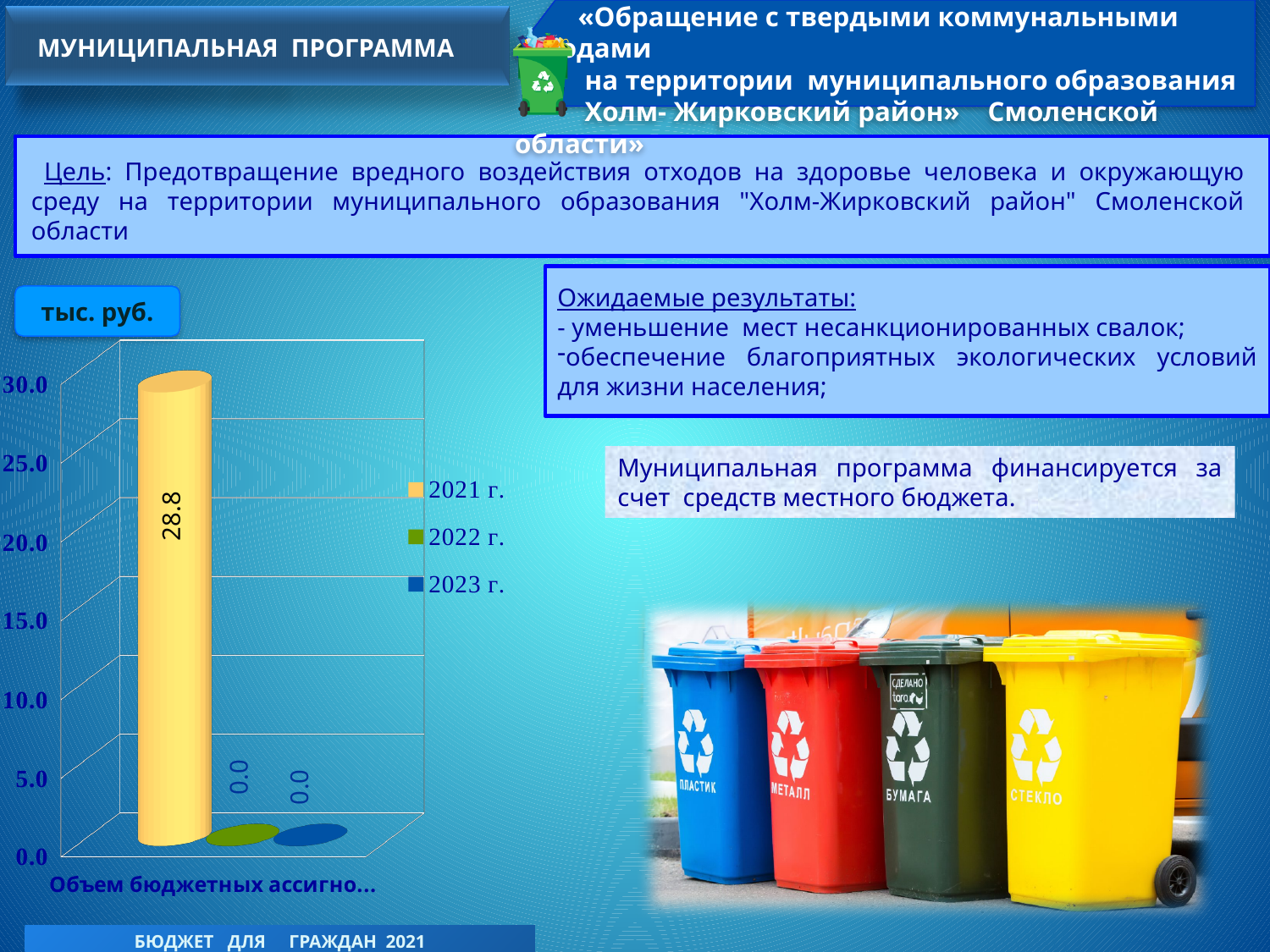
Which year has the highest value in the chart? 2021 г. What is the difference between the values for 2021 г. and 2022 г.? 28.8 What is the value for 2023 г. in the chart? 0.0 What is the highest tick value shown on the chart's vertical axis? 30.0 Is the value for 2021 г. greater or less than 25.0? greater What unit is indicated for the chart values? тыс. руб. Do the values fall or rise from 2021 г. to 2023 г.? fall What kind of chart is shown on the slide? bar chart What is the value for 2021 г. in the chart? 28.8 Which is larger, the value for 2021 г. or the value for 2023 г.? 2021 г. What is the value for 2022 г. in the chart? 0.0 How many series does the chart legend list? 3